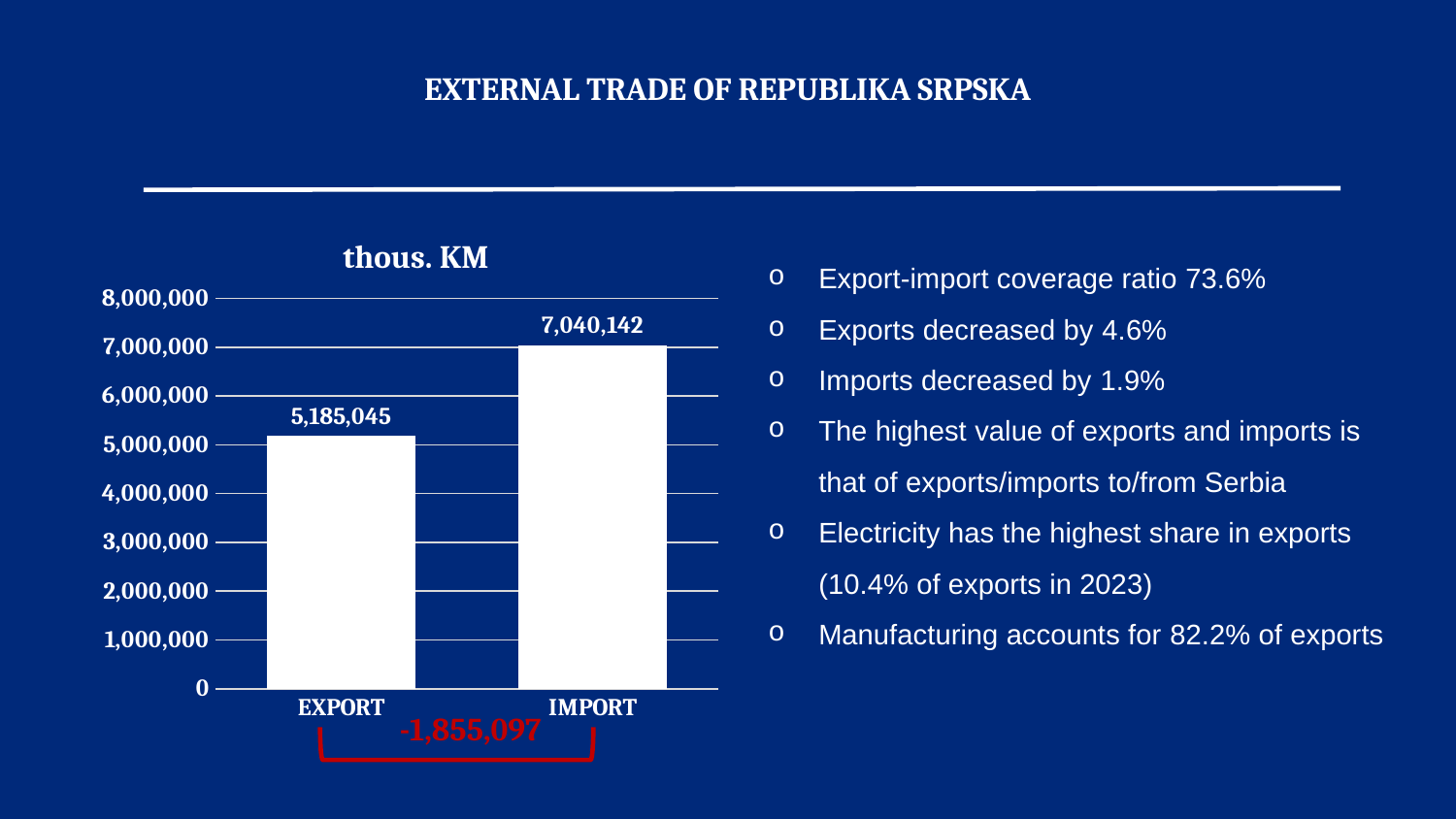
Which category has the highest value in the chart? IMPORT What value is shown in red below the chart between the two bars? -1,855,097 Is the value for IMPORT greater or less than 8,000,000? less What is the difference between the IMPORT and EXPORT values? 1,855,097 What is the value for IMPORT in the chart? 7,040,142 Is the value for EXPORT greater or less than 5,000,000? greater How many categories are shown in the chart? 2 What is the value for EXPORT in the chart? 5,185,045 What kind of chart is shown on the slide? bar chart Which is larger, the value for EXPORT or the value for IMPORT? IMPORT Which category has the lowest value in the chart? EXPORT What is the title of the chart? thous. KM